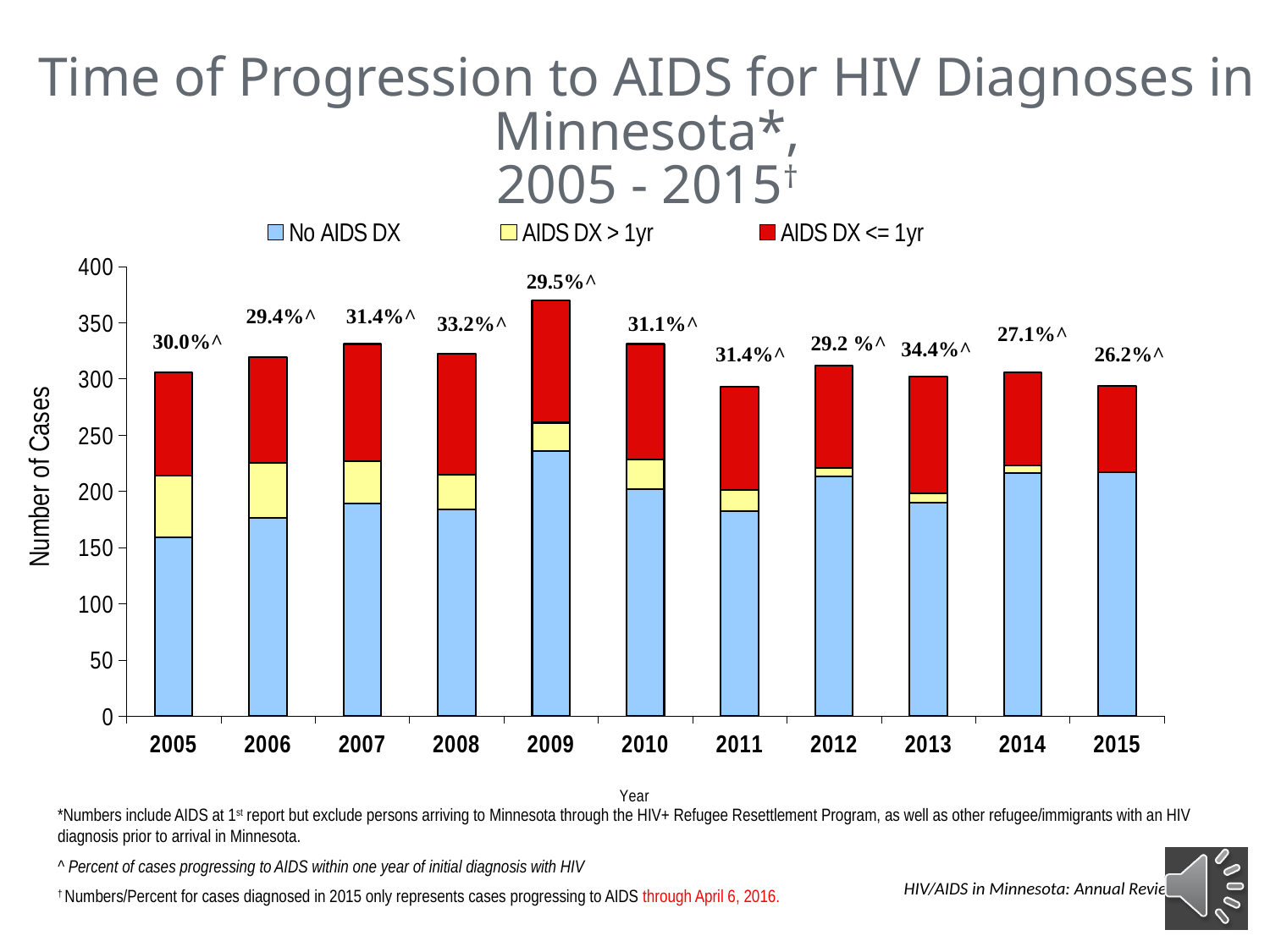
How many series does the legend list? 3 Which year has the taller total bar, 2009 or 2010? 2009 What is the difference between the percentage labels for 2013 and 2015? 8.2 percentage points What percentage label is shown above the bar for 2015? 26.2%^ What type of chart is shown on the slide? Stacked bar chart What percentage label is shown above the bar for 2013? 34.4%^ Is the total number of cases for 2009 greater or less than 350? greater How many years are shown on the x axis? 11 Which year has the lowest percentage label above its bar? 2015 Which year has the highest percentage label above its bar? 2013 What percentage label is shown above the bar for 2005? 30.0%^ Is the total number of cases for 2011 greater or less than 300? less